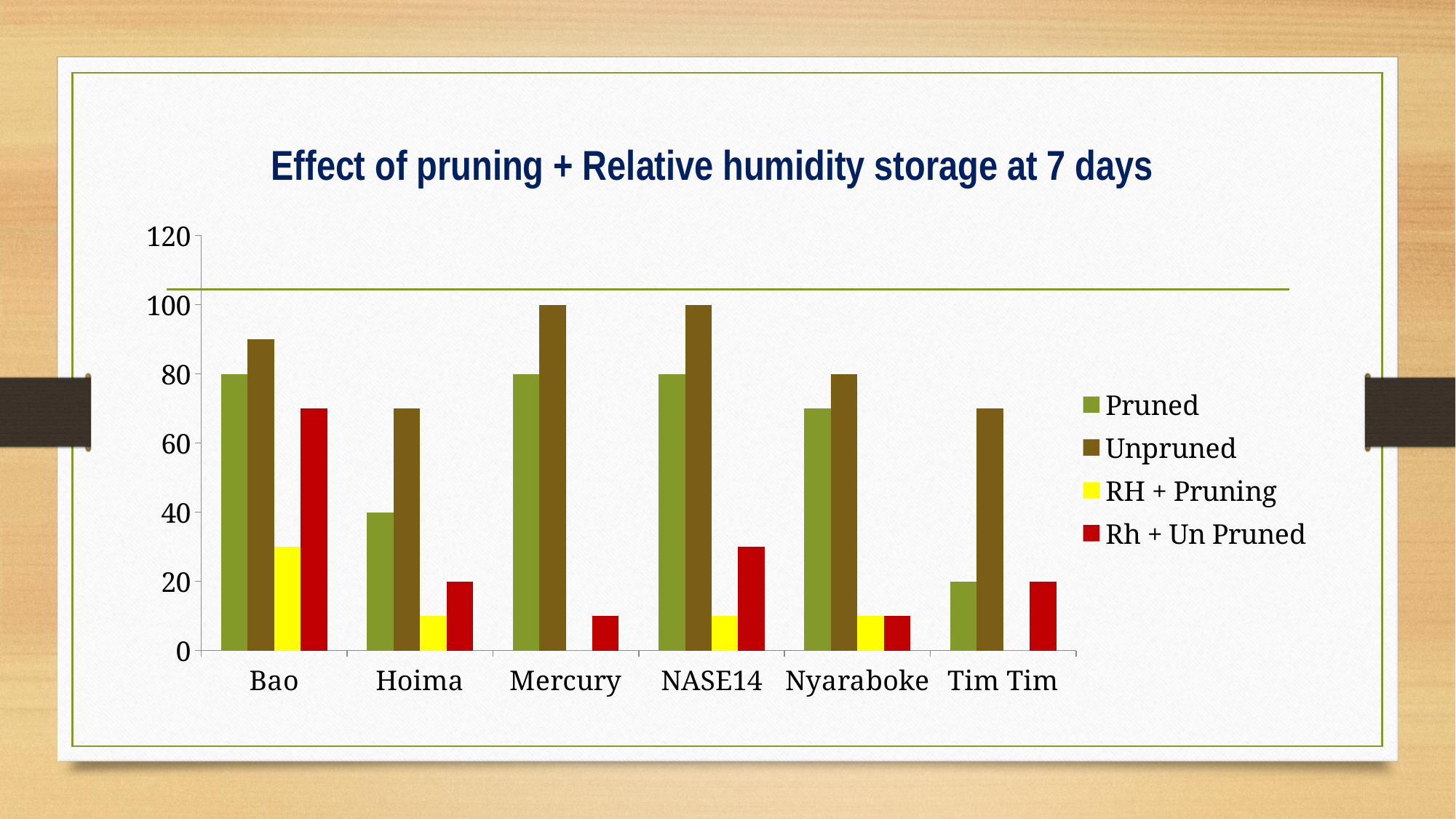
What is the Pruned value for Tim Tim? 20 What kind of chart is shown on the slide? bar chart What is the Pruned value for Hoima? 40 Which variety has the lowest Pruned value? Tim Tim What is the title of the chart? Effect of pruning + Relative humidity storage at 7 days Is the RH + Pruning value for NASE14 greater or less than 20? less How many varieties are shown along the x axis? 6 How many series does the legend list? 4 For Hoima, which is larger: the Pruned value or the Unpruned value? Unpruned Which variety has the highest Rh + Un Pruned value? Bao What is the Unpruned value for Mercury? 100 Is the Rh + Un Pruned value for Bao greater or less than 60? greater